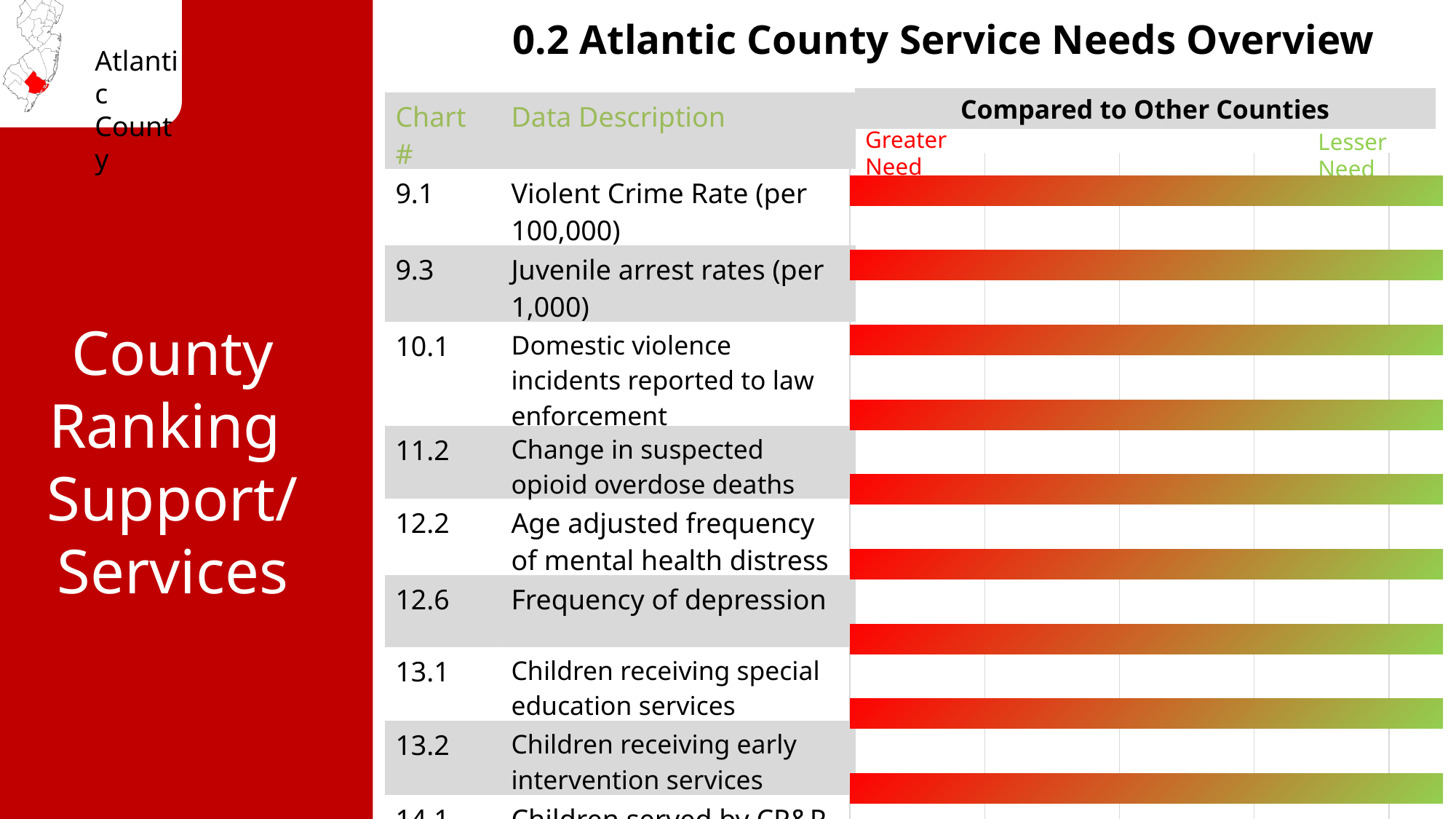
Which chart number is listed for "Frequency of depression"? 12.6 What is the title printed above the bars on the right side of the slide? Compared to Other Counties Which chart number is listed for "Children receiving early intervention services"? 13.2 Which chart number is listed for "Violent Crime Rate (per 100,000)"? 9.1 What kind of chart is shown under the heading "Compared to Other Counties"? bar chart What is the main title of the slide? 0.2 Atlantic County Service Needs Overview What data description is listed for chart number 10.1? Domestic violence incidents reported to law enforcement How many gradient bars are shown in the "Compared to Other Counties" chart? 9 What data description is listed for chart number 11.2? Change in suspected opioid overdose deaths What label appears at the left end of the bar scale? Greater Need